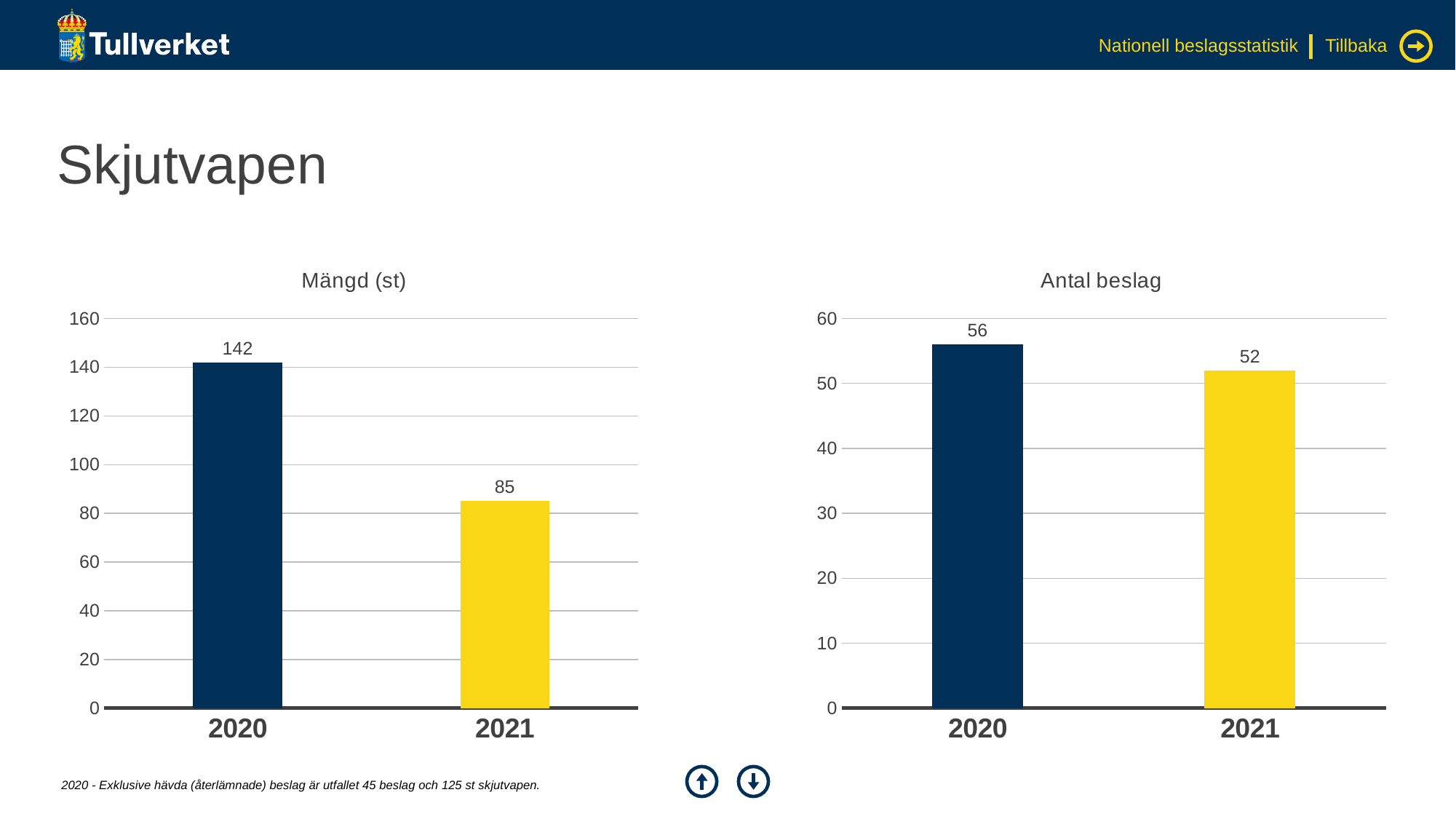
In the 'Antal beslag' chart, what is the value for 2020? 56 In the 'Antal beslag' chart, what is the difference between the values for 2020 and 2021? 4 In the 'Antal beslag' chart, is the value for 2020 greater or less than 50? greater In the 'Mängd (st)' chart, what is the difference between the values for 2020 and 2021? 57 How many categories are shown in the 'Mängd (st)' chart? 2 In the 'Antal beslag' chart, which year has the lowest value? 2021 In the 'Mängd (st)' chart, which year has the highest value? 2020 What kind of chart is the 'Antal beslag' chart? bar chart In the 'Mängd (st)' chart, do the values rise or fall from 2020 to 2021? fall In the 'Mängd (st)' chart, what is the value for 2021? 85 In the 'Mängd (st)' chart, what is the value for 2020? 142 In the 'Antal beslag' chart, what is the value for 2021? 52